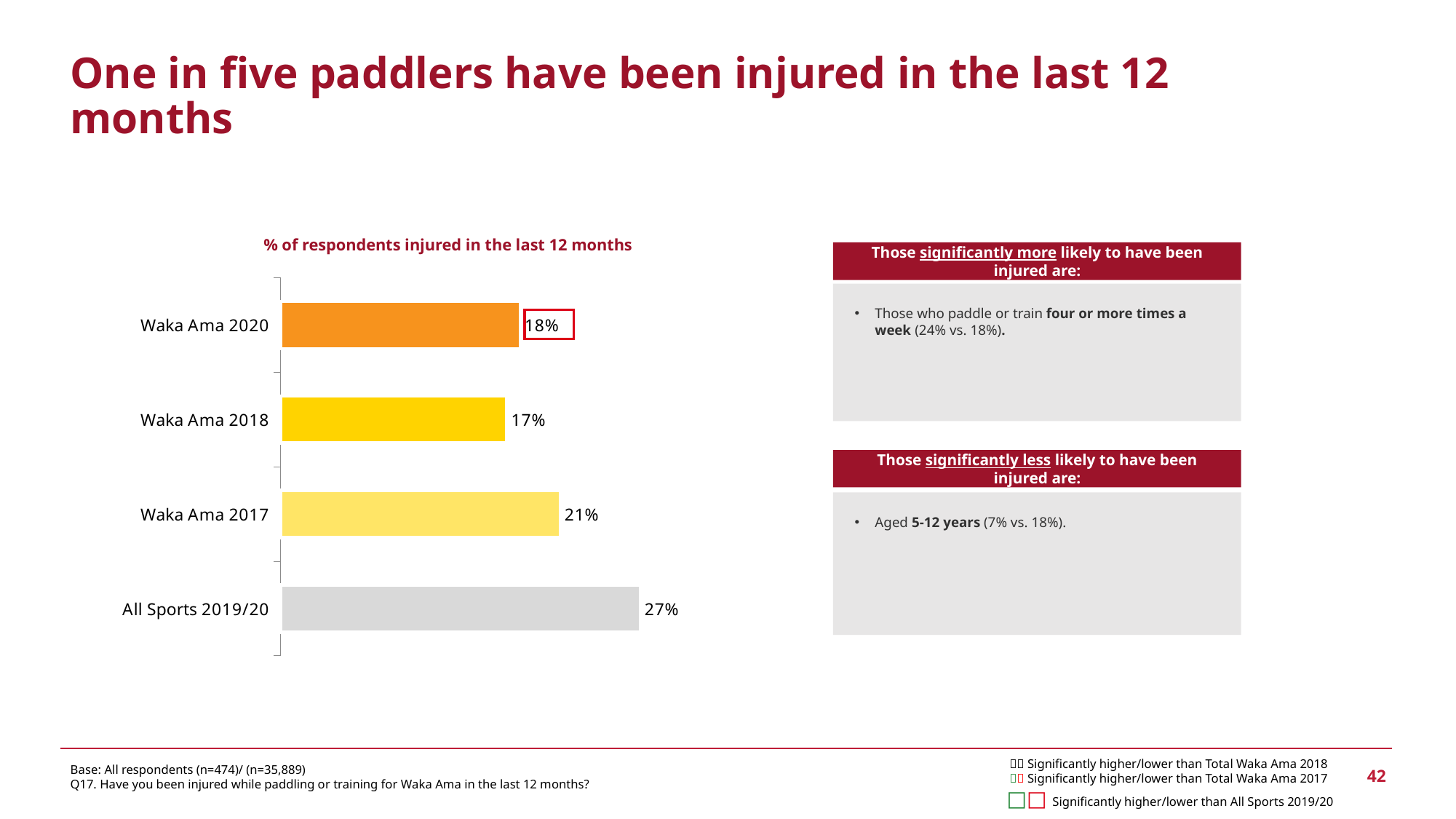
What is the difference between the All Sports 2019/20 value and the Waka Ama 2020 value? 9 percentage points Which is larger, the value for Waka Ama 2017 or Waka Ama 2020? Waka Ama 2017 How many categories are shown in the bar chart? 4 Which category has the lowest percentage of respondents injured? Waka Ama 2018 What is the difference between the Waka Ama 2017 and Waka Ama 2018 values? 4 percentage points Which category has the highest percentage of respondents injured? All Sports 2019/20 What is the value shown for Waka Ama 2017? 21% What is the title of the chart? % of respondents injured in the last 12 months What is the value shown for All Sports 2019/20? 27% What percentage of respondents were injured in the last 12 months for Waka Ama 2020? 18% What is the value shown for Waka Ama 2018? 17% What type of chart is used to show the percentage of respondents injured? Bar chart